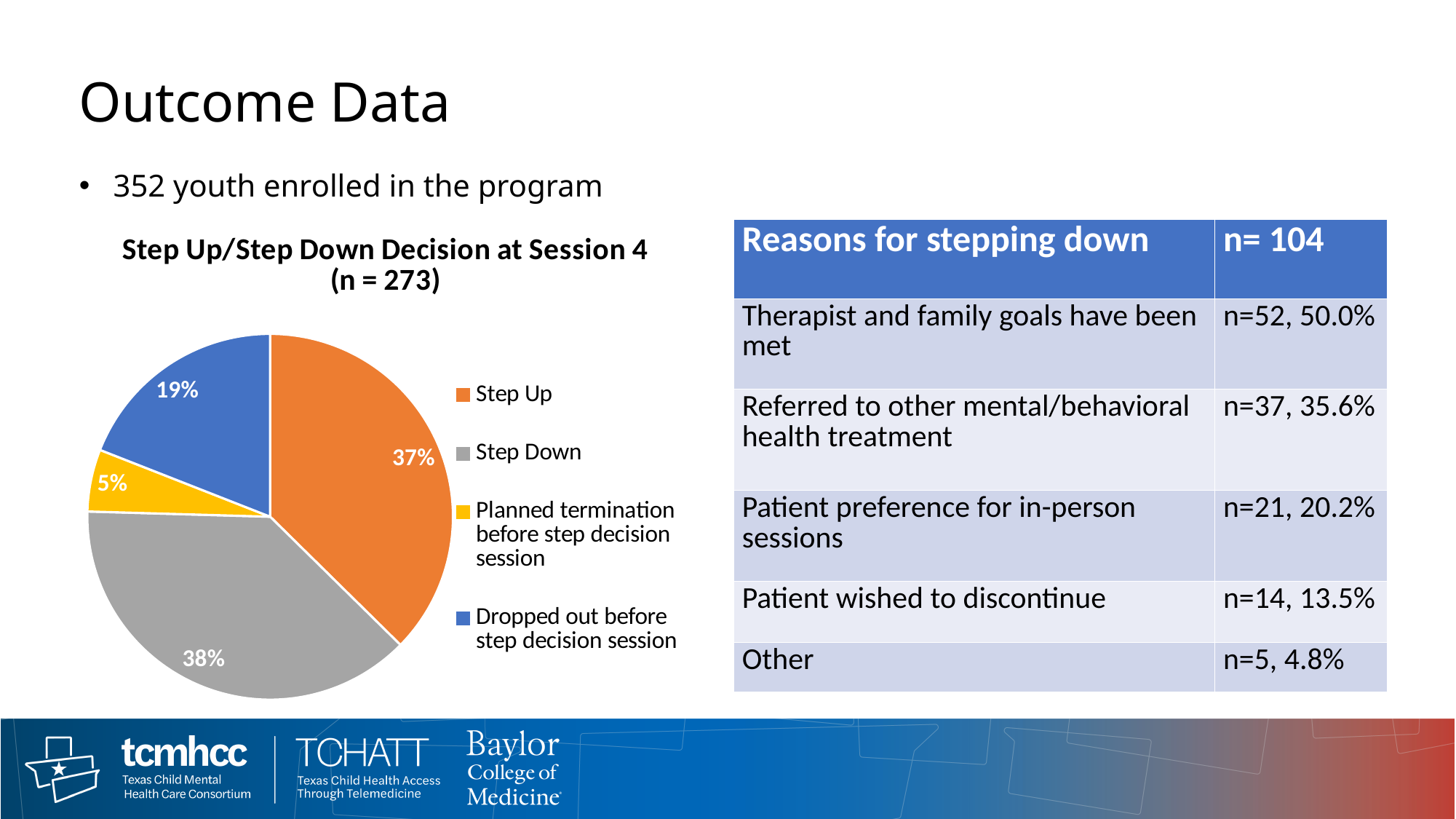
What is the title of the pie chart? Step Up/Step Down Decision at Session 4 (n = 273) What percentage of the pie chart is Step Down? 38% What percentage of the pie chart is Dropped out before step decision session? 19% What is the difference in percentage points between Step Down and Dropped out before step decision session? 19 What percentage of the pie chart is Step Up? 37% What type of chart is shown on the slide? Pie chart How many categories does the pie chart legend list? 4 What is the combined percentage of Step Up and Step Down in the pie chart? 75% What percentage of the pie chart is Planned termination before step decision session? 5% Which is larger in the pie chart: Dropped out before step decision session or Planned termination before step decision session? Dropped out before step decision session Which category has the smallest share of the pie chart? Planned termination before step decision session What colour represents Step Up in the pie chart? Orange